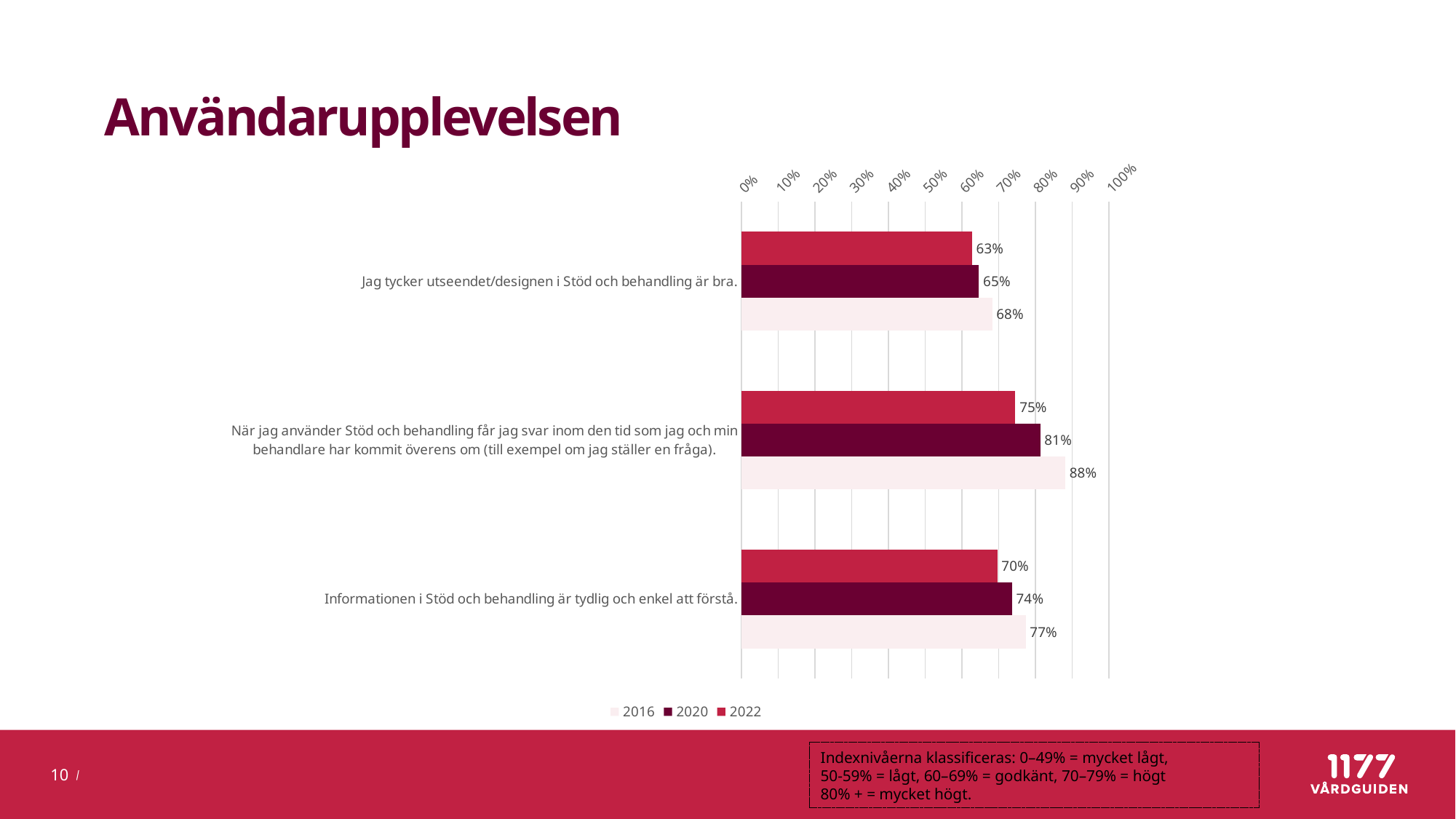
How many statements (categories) are shown in the chart? 3 What kind of chart is shown on the slide? bar chart How many series does the legend list? 3 Which statement has the highest 2022 value? När jag använder Stöd och behandling får jag svar inom den tid som jag och min behandlare har kommit överens om What is the difference between the 2016 and 2022 values for "När jag använder Stöd och behandling får jag svar inom den tid som jag och min behandlare har kommit överens om"? 13% What is the 2016 value for "När jag använder Stöd och behandling får jag svar inom den tid som jag och min behandlare har kommit överens om"? 88% Which year is shown in the lightest (pale pink) colour in the legend? 2016 Which statement has the lowest 2016 value? Jag tycker utseendet/designen i Stöd och behandling är bra. For "Jag tycker utseendet/designen i Stöd och behandling är bra.", do the values rise or fall from 2016 to 2022? fall What is the 2020 value for "Informationen i Stöd och behandling är tydlig och enkel att förstå."? 74% For "Informationen i Stöd och behandling är tydlig och enkel att förstå.", which year has the larger value, 2016 or 2022? 2016 What is the 2022 value for "Jag tycker utseendet/designen i Stöd och behandling är bra."? 63%